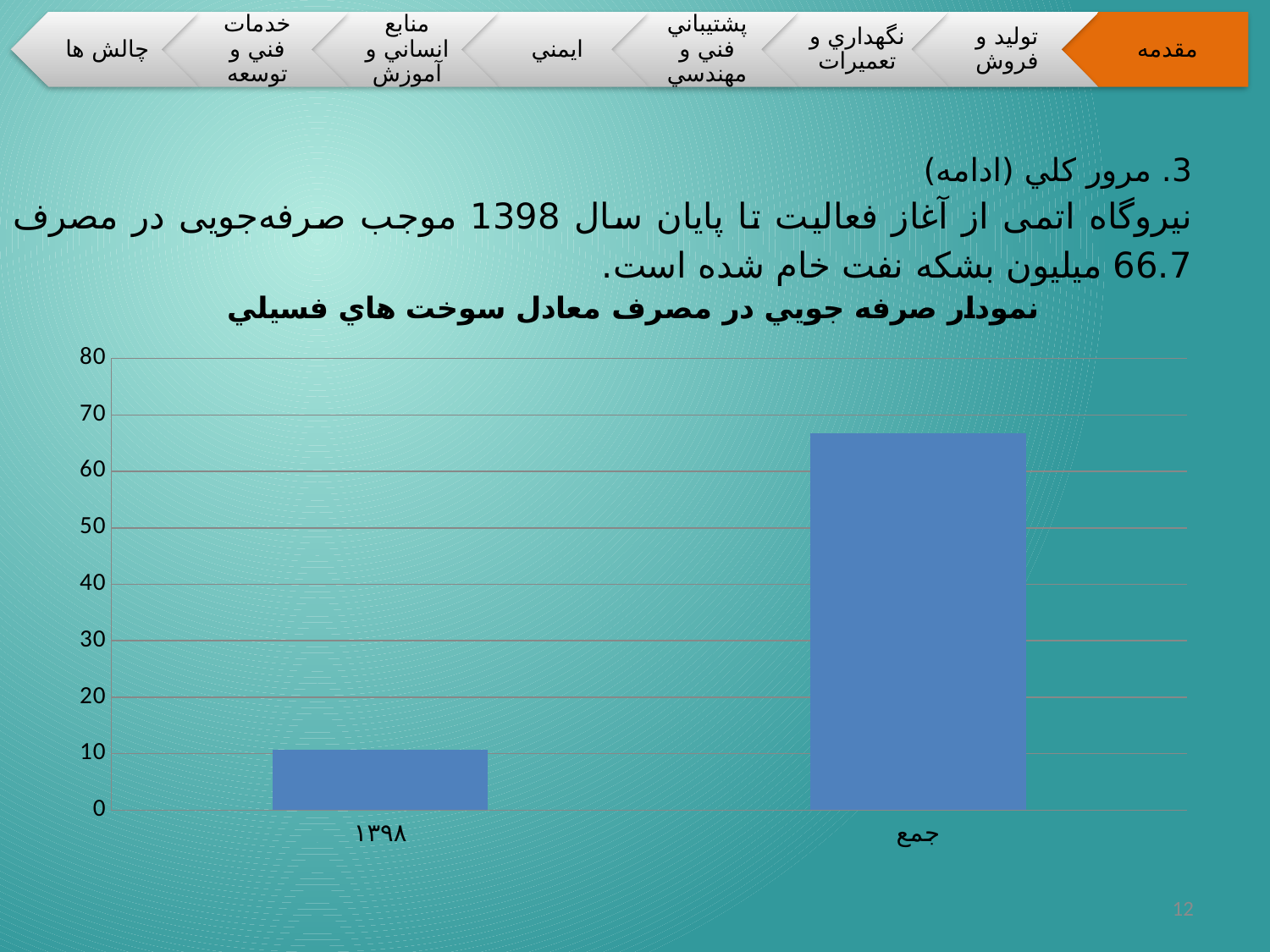
Which category has the lowest bar in the chart? ۱۳۹۸ What kind of chart is shown on the slide? bar chart Is the value for جمع greater or less than 60? greater Is the value for ۱۳۹۸ greater or less than 20? less Which bar is taller, ۱۳۹۸ or جمع? جمع Is the value for ۱۳۹۸ greater or less than 5? greater What is the highest value shown on the chart's vertical axis? 80 Which category has the highest bar in the chart? جمع How many categories are plotted on the x axis of the chart? 2 What is the title of the chart? نمودار صرفه جويي در مصرف معادل سوخت هاي فسيلي